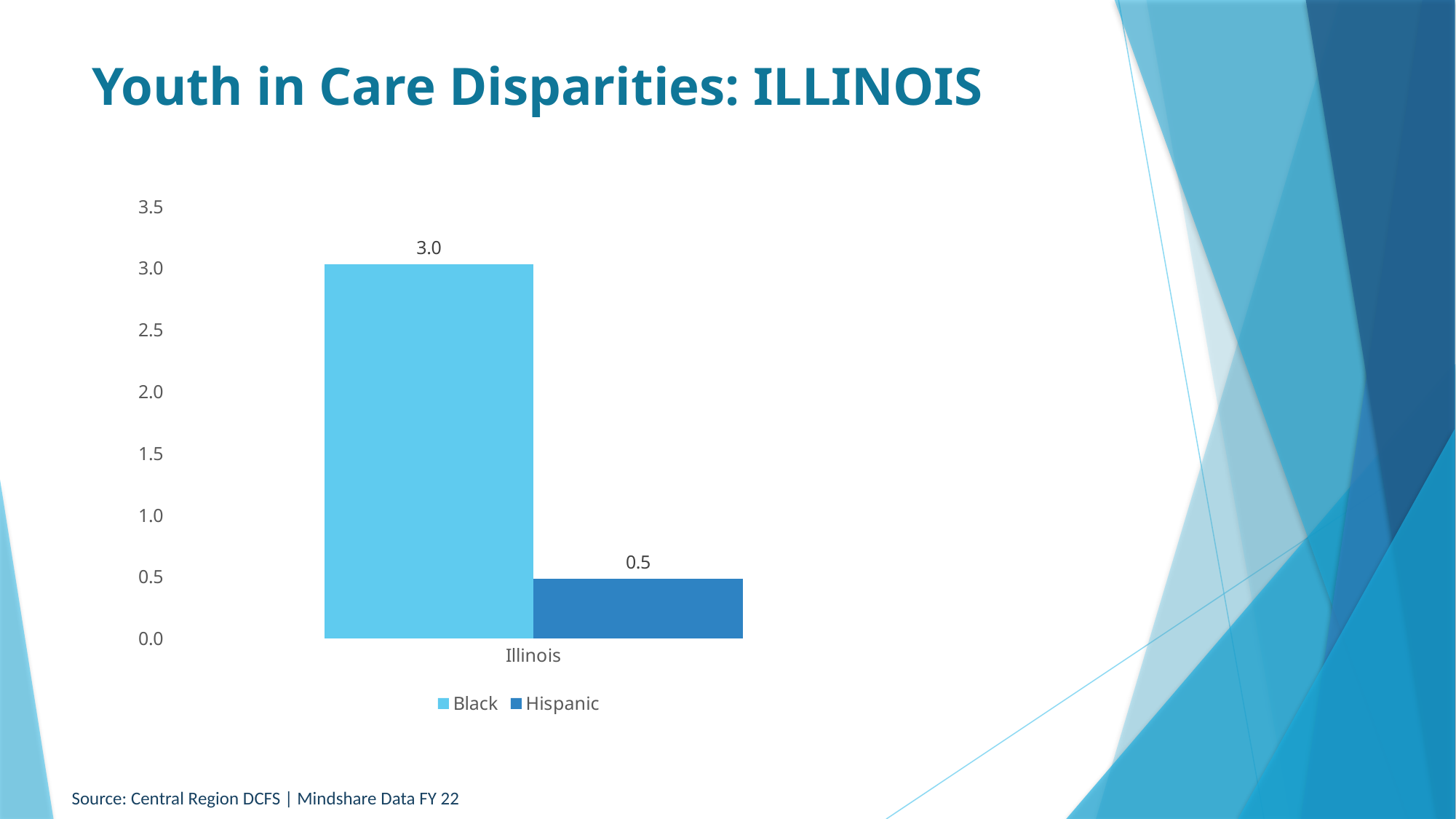
What is the difference between the Black and Hispanic values for Illinois? 2.5 What is the title of the slide? Youth in Care Disparities: ILLINOIS What kind of chart is shown on the slide? Bar chart Which series has the higher value for Illinois, Black or Hispanic? Black Is the value for Black greater or less than 2.0? greater How many series does the legend list? 2 What is the value for Hispanic in Illinois? 0.5 What is the value for Black in Illinois? 3.0 What is the highest value shown on the y axis? 3.5 Which series has the lowest value on the chart? Hispanic How many categories are shown on the x axis? 1 Is the value for Hispanic greater or less than 1.0? less